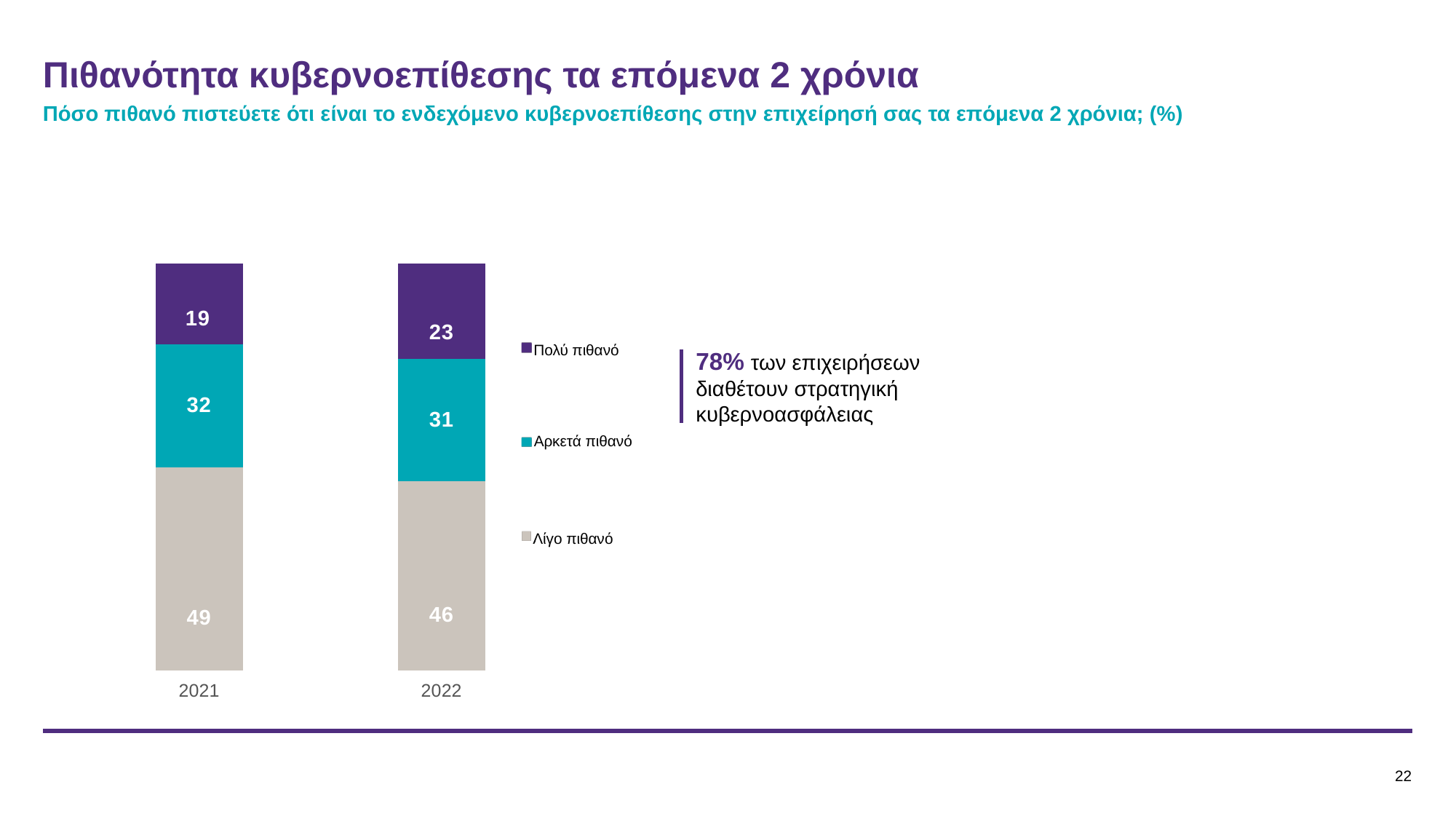
Which year has the higher value for "Πολύ πιθανό", 2021 or 2022? 2022 What is the value for "Λίγο πιθανό" in 2021? 49 What is the value for "Αρκετά πιθανό" in 2022? 31 Which series has the smallest value in 2021? Πολύ πιθανό How many years are shown on the x axis? 2 What is the difference between the "Λίγο πιθανό" values for 2021 and 2022? 3 What is the value for "Πολύ πιθανό" in 2022? 23 What is the difference between the "Πολύ πιθανό" values for 2022 and 2021? 4 Which series has the largest value in 2022? Λίγο πιθανό How many series does the legend list? 3 What is the total of the stacked bar for 2021? 100 What kind of chart is shown on the slide? Stacked bar chart